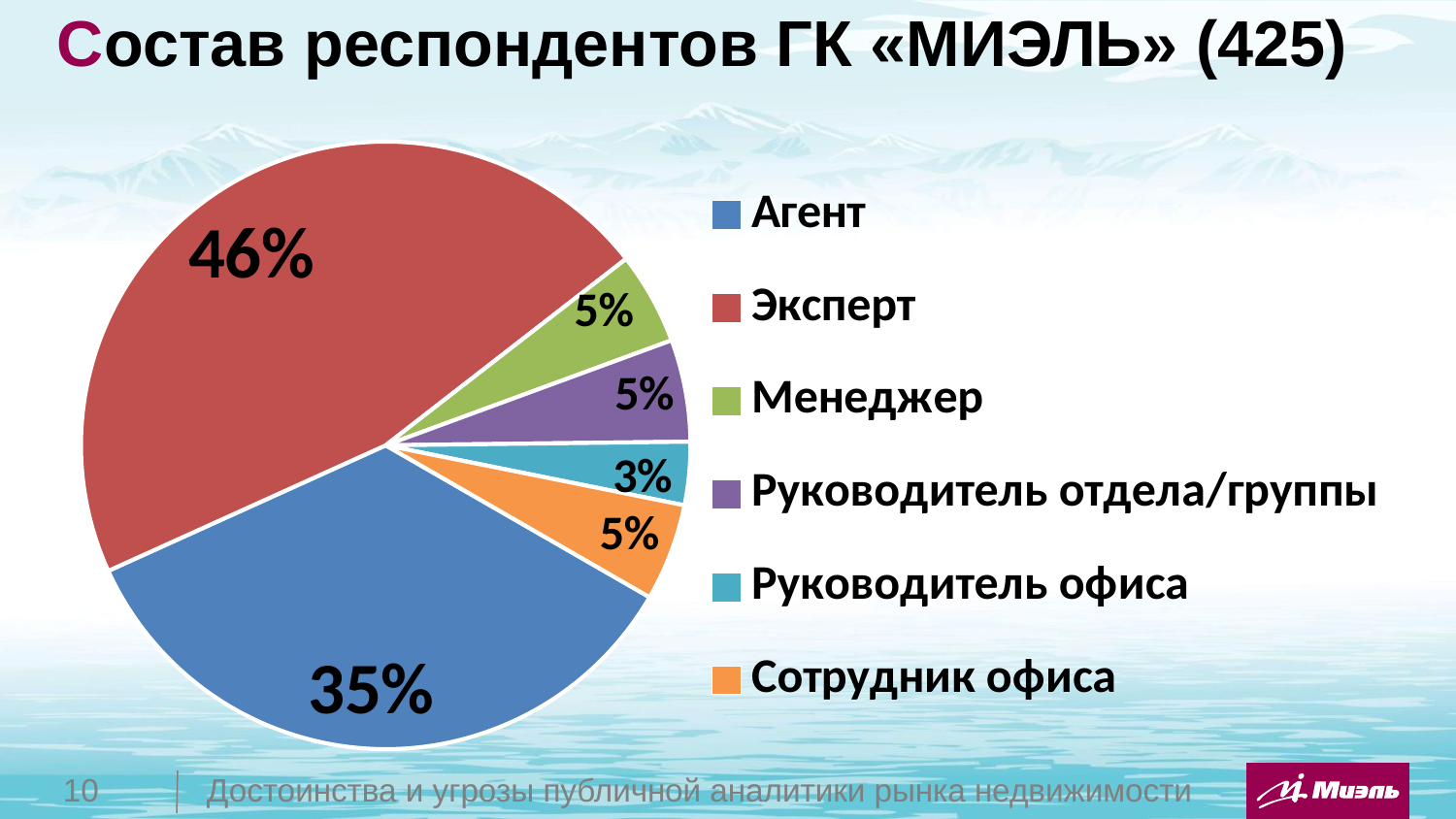
What share of respondents are Сотрудник офиса? 5% What share of respondents are Агент? 35% What share of respondents are Эксперт? 46% What type of chart is shown on the slide? Pie chart Which colour represents Менеджер in the pie chart? Green Which category has the smallest share of respondents? Руководитель офиса Which category has the largest share of respondents? Эксперт Which is larger, the share of Агент or the share of Эксперт? Эксперт What share of respondents are Руководитель офиса? 3% How many categories does the pie chart show? 6 What is the title of the chart on the slide? Состав респондентов ГК «МИЭЛЬ» (425) What is the difference in percentage points between the Эксперт and Агент shares? 11